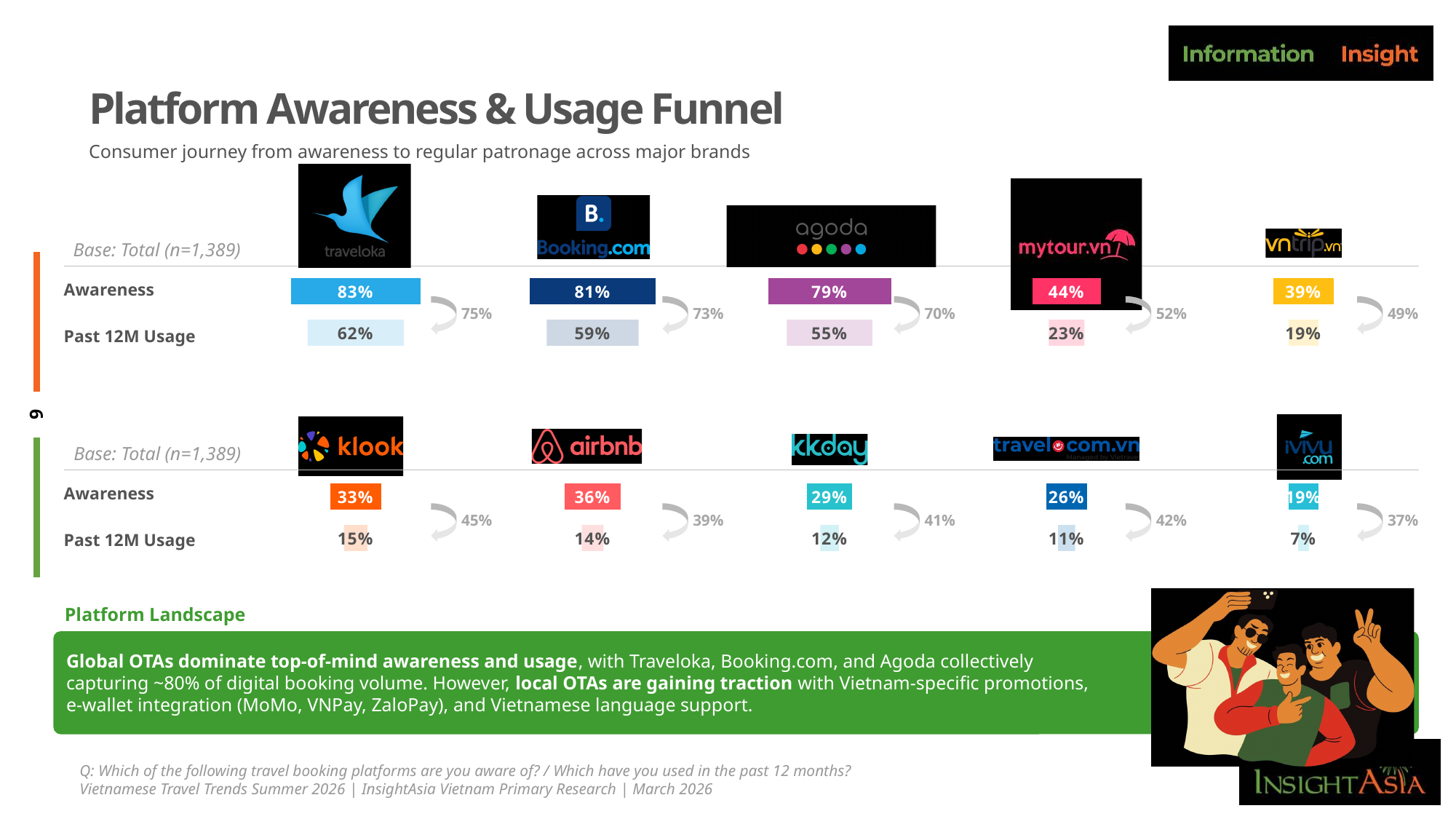
What is the Past 12M Usage value for iVIVU.com? 7% Which is larger, the Awareness for mytour.vn or the Awareness for vntrip.vn? mytour.vn What is the base sample size stated for the funnel? n=1,389 What is the difference between Awareness and Past 12M Usage for Booking.com? 22% What is the Awareness value for Traveloka? 83% What is the Awareness value for Airbnb? 36% Which brand has the lowest Past 12M Usage? iVIVU.com What is the Past 12M Usage value for Agoda? 55% What kind of chart is used to show the Awareness and Past 12M Usage values? Bar chart What is the conversion percentage shown between Awareness and Past 12M Usage for Klook? 45% How many brands are shown in the funnel? 10 Which brand has the highest Awareness? Traveloka